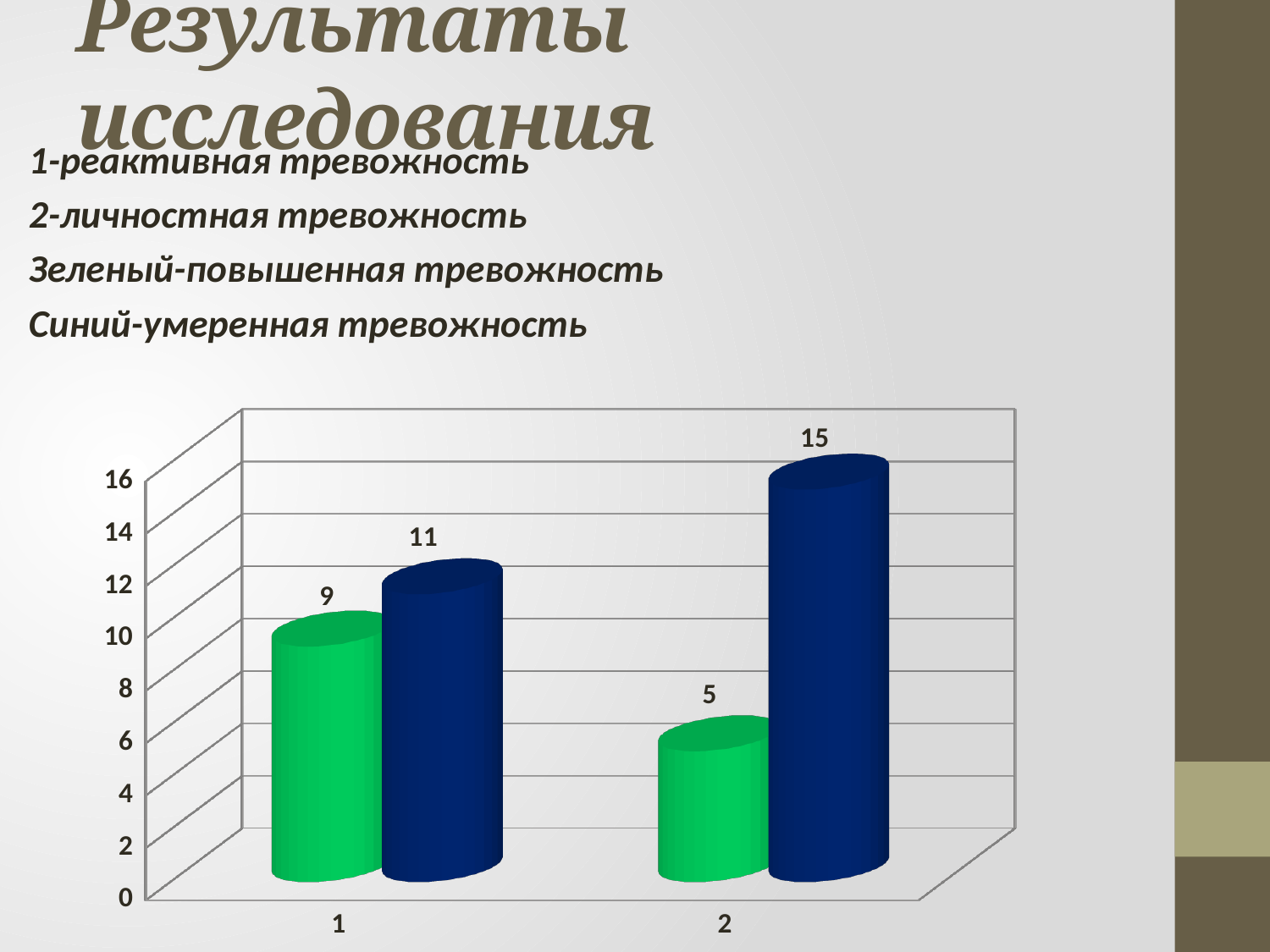
What is the difference between the blue and green bars for category 1? 2 Which bar has the lowest value on the chart? Green bar for category 2 (5) What is the value of the blue bar for category 1? 11 Which is larger for category 1, the green bar or the blue bar? Blue bar According to the slide text, what does the green colour represent? Повышенная тревожность What is the value of the green bar for category 2? 5 What is the value of the green bar for category 1? 9 What is the value of the blue bar for category 2? 15 What kind of chart is shown on the slide? Bar chart What is the difference between the blue and green bars for category 2? 10 How many categories are shown on the x axis? 2 Which bar has the highest value on the chart? Blue bar for category 2 (15)